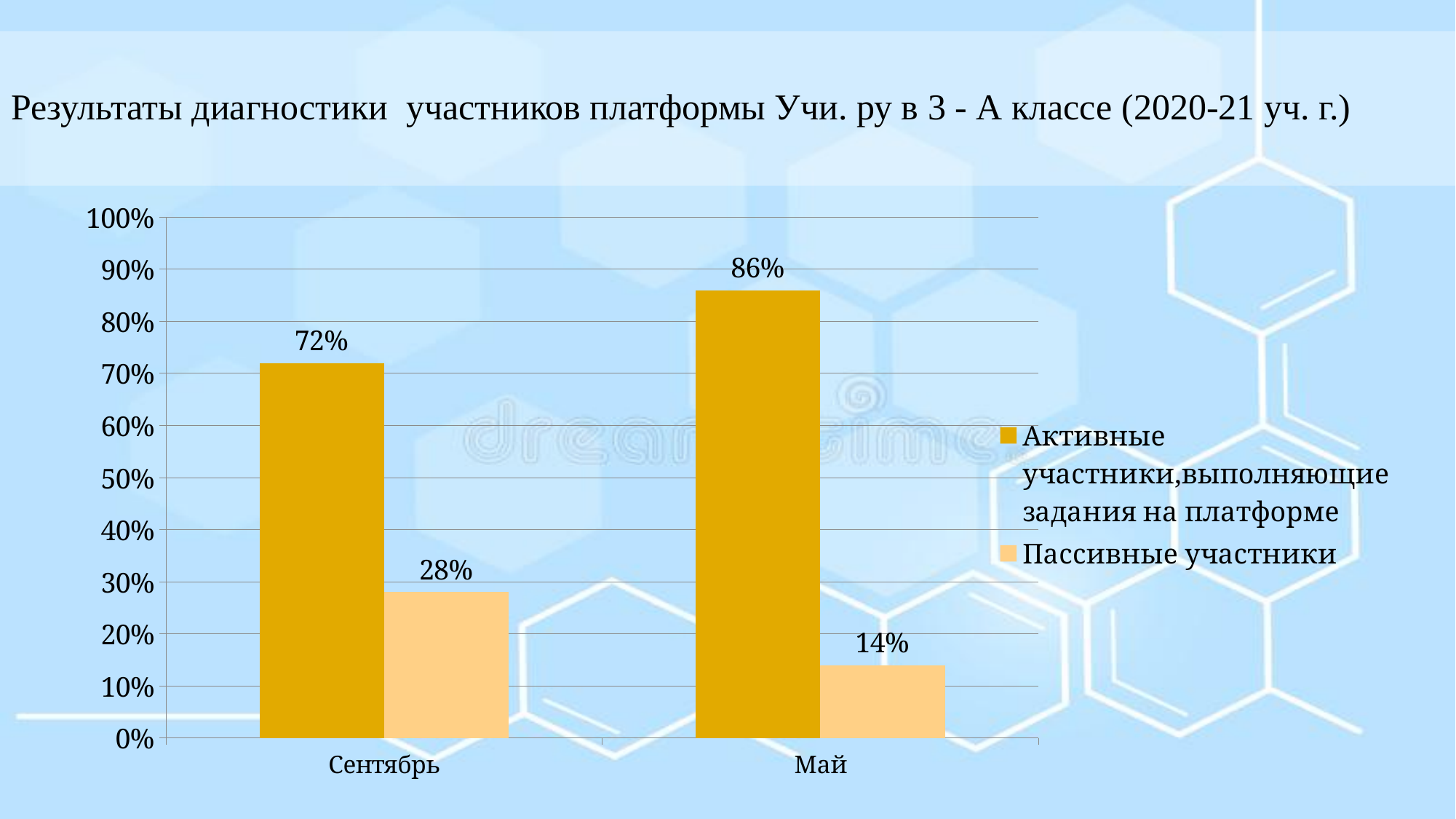
How many categories are shown on the x axis? 2 How many series does the legend list? 2 Which is larger: passive participants in Сентябрь or passive participants in Май? Сентябрь Which colour represents passive participants (Пассивные участники) in the legend? Light orange What is the value for active participants (Активные участники) in Сентябрь? 72% Do the values for active participants rise or fall from Сентябрь to Май? Rise Which category has the lowest value for passive participants (Пассивные участники)? Май What kind of chart is shown on the slide? Bar chart Which category has the highest value for active participants (Активные участники)? Май What is the value for passive participants (Пассивные участники) in Май? 14% What is the value for passive participants (Пассивные участники) in Сентябрь? 28% What is the difference between the active participants values in Май and Сентябрь? 14%